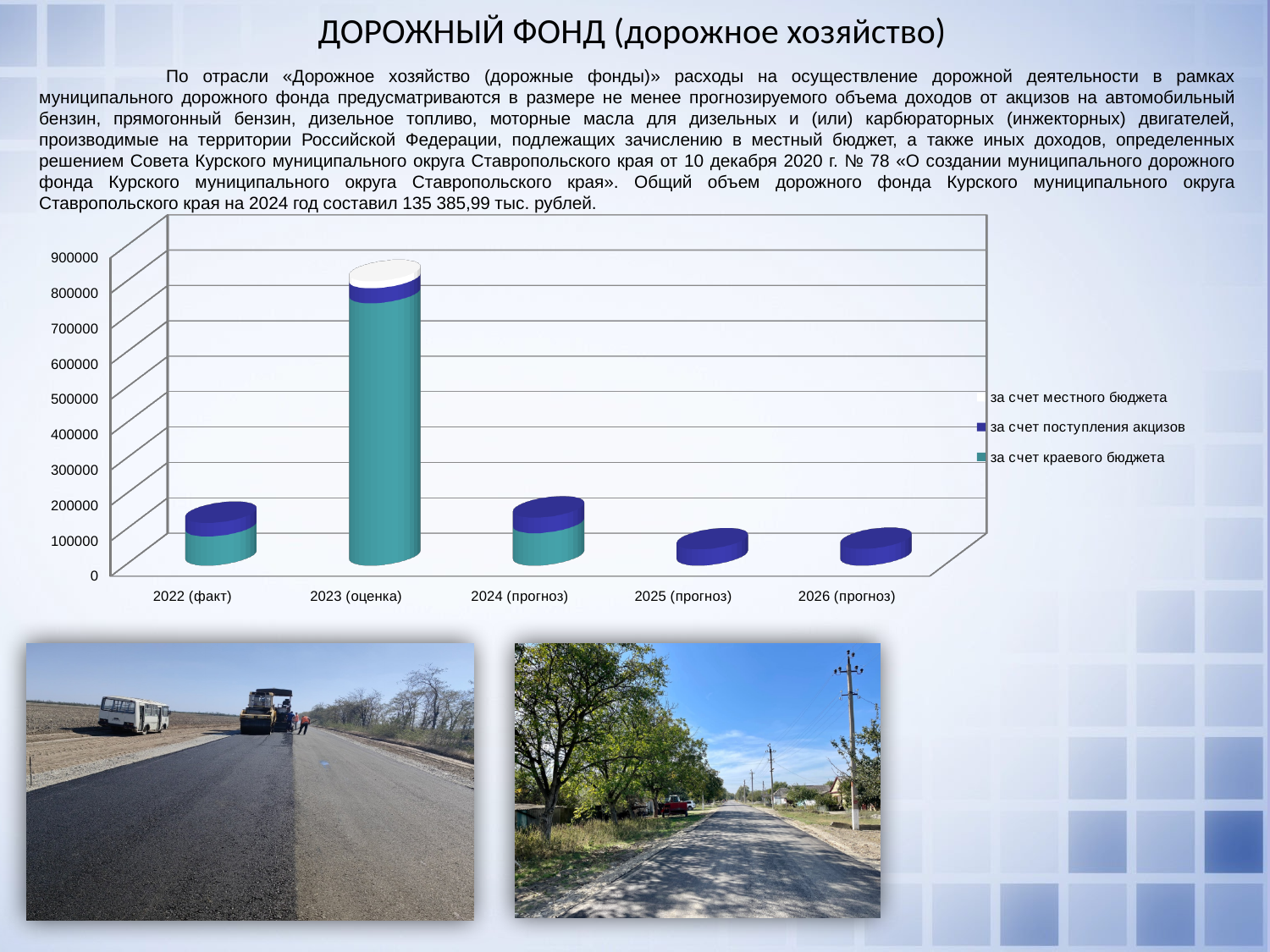
Which series is the only one shown in the bars for 2025 (прогноз) and 2026 (прогноз)? за счет поступления акцизов What kind of chart is shown on the slide? bar chart Which is larger, the total bar for 2023 (оценка) or for 2024 (прогноз)? 2023 (оценка) Is the total value for 2025 (прогноз) greater or less than 200000? less Which legend series appears only in the 2023 (оценка) bar? за счет местного бюджета Is the total value for 2024 (прогноз) greater or less than 400000? less How many series does the chart legend list? 3 Which category has the highest total bar in the chart? 2023 (оценка) Is the total value for 2022 (факт) greater or less than 300000? less Which is larger, the total bar for 2022 (факт) or for 2026 (прогноз)? 2022 (факт) How many categories are shown on the x axis of the chart? 5